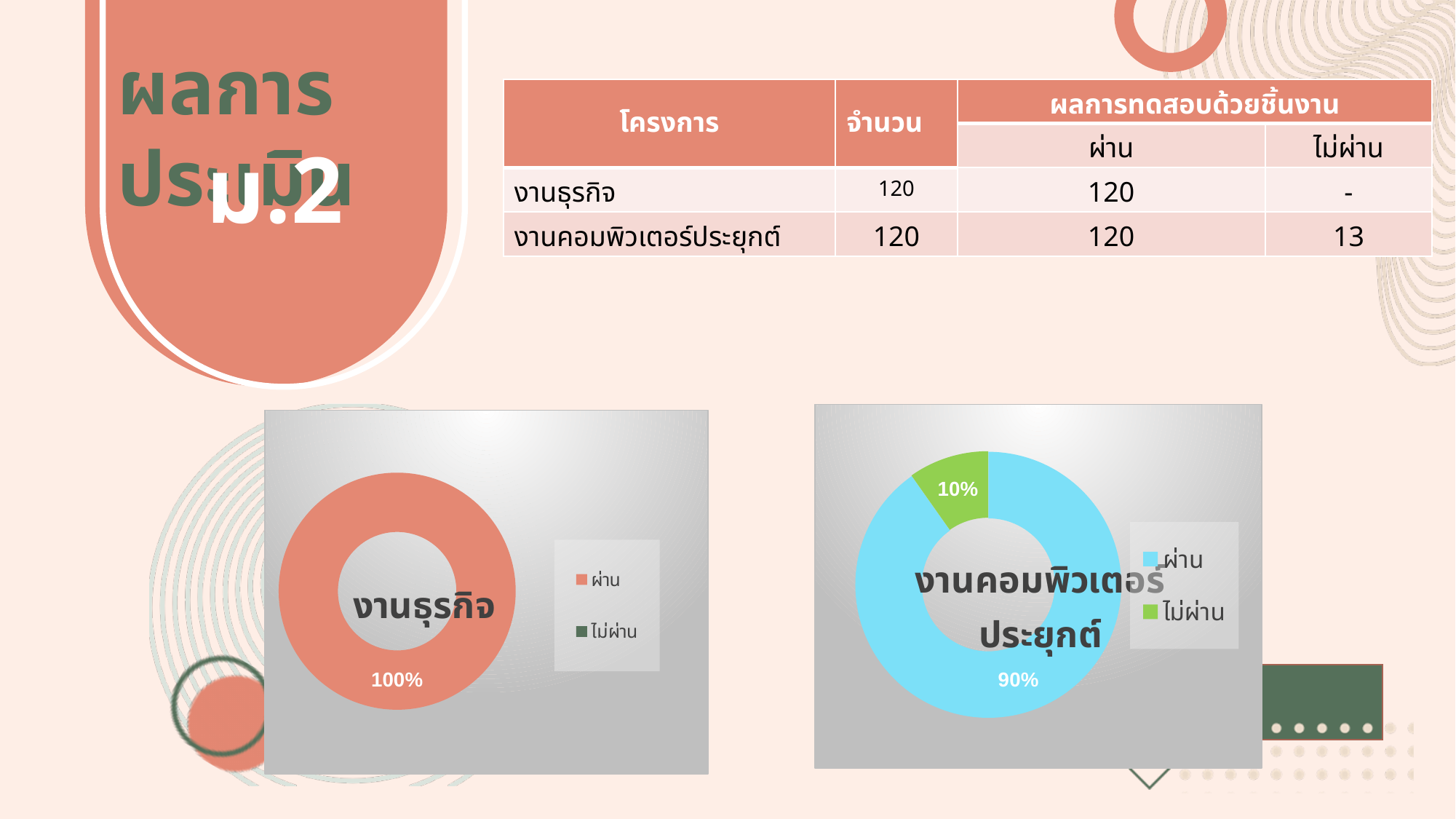
How many entries does the legend of the งานคอมพิวเตอร์ประยุกต์ chart list? 2 What kind of chart is the งานธุรกิจ chart? Doughnut chart In the งานคอมพิวเตอร์ประยุกต์ chart, what percentage is shown for ไม่ผ่าน? 10% In the งานธุรกิจ chart, what colour represents ผ่าน? Orange In the งานธุรกิจ chart, what percentage is shown for ผ่าน? 100% In the งานคอมพิวเตอร์ประยุกต์ chart, which category has the smallest share? ไม่ผ่าน In the งานคอมพิวเตอร์ประยุกต์ chart, what colour represents ไม่ผ่าน? Green In the งานคอมพิวเตอร์ประยุกต์ chart, which is larger, ผ่าน or ไม่ผ่าน? ผ่าน In the งานคอมพิวเตอร์ประยุกต์ chart, what is the difference in percentage points between ผ่าน and ไม่ผ่าน? 80 In the งานคอมพิวเตอร์ประยุกต์ chart, what percentage is shown for ผ่าน? 90% In the งานคอมพิวเตอร์ประยุกต์ chart, which category has the largest share? ผ่าน How many charts are shown on the slide? 2